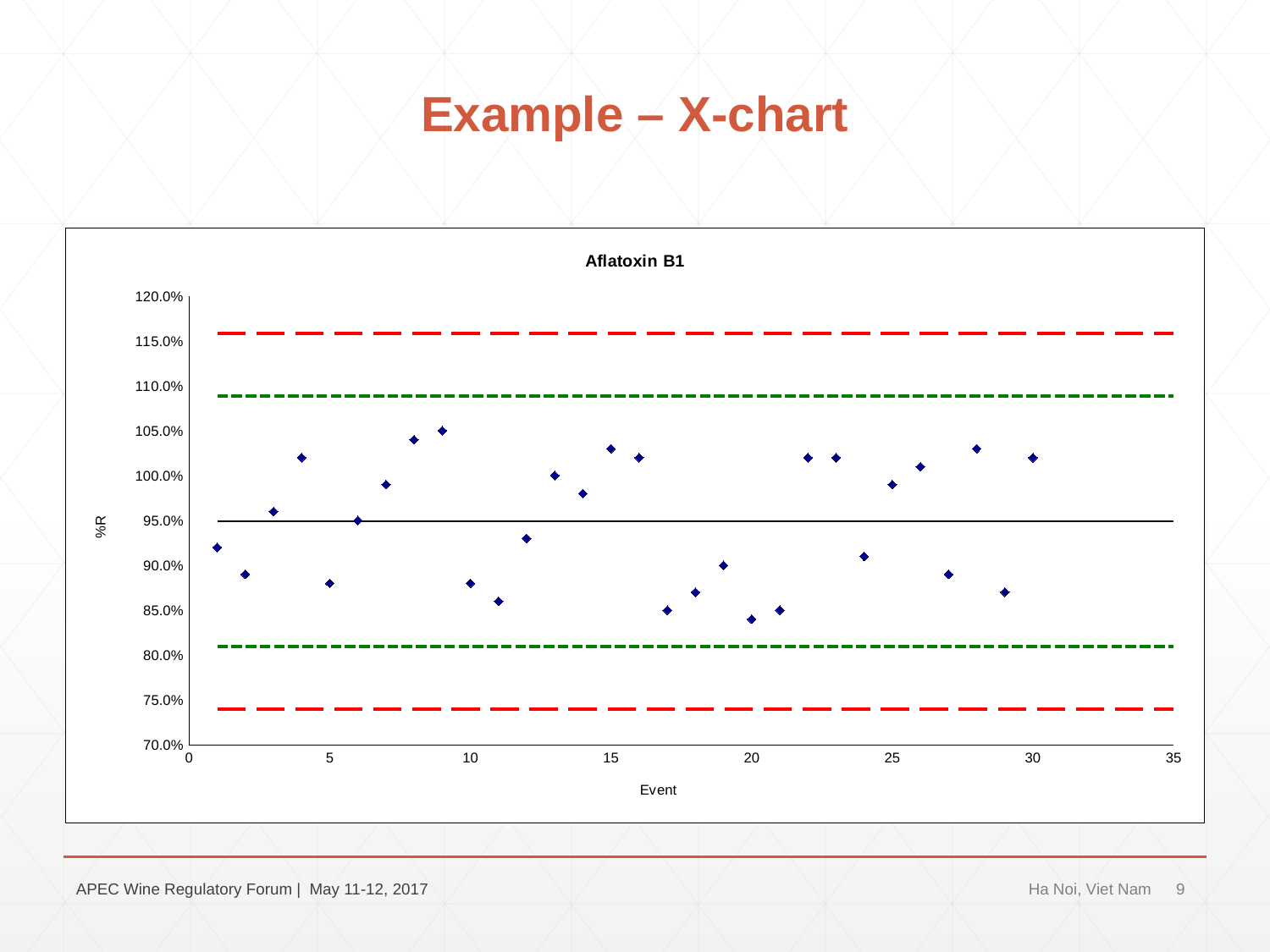
Is the value for Event 9 greater or less than 100.0%? greater What kind of chart is shown on the slide? scatter chart What is the label of the y-axis? %R Which has the larger %R value, Event 1 or Event 4? Event 4 Which has the larger %R value, Event 9 or Event 20? Event 9 Is the value for Event 20 greater or less than 90.0%? less How many data points are plotted on the chart? 30 Is the value for Event 1 greater or less than 95.0%? less What is the title of the chart? Aflatoxin B1